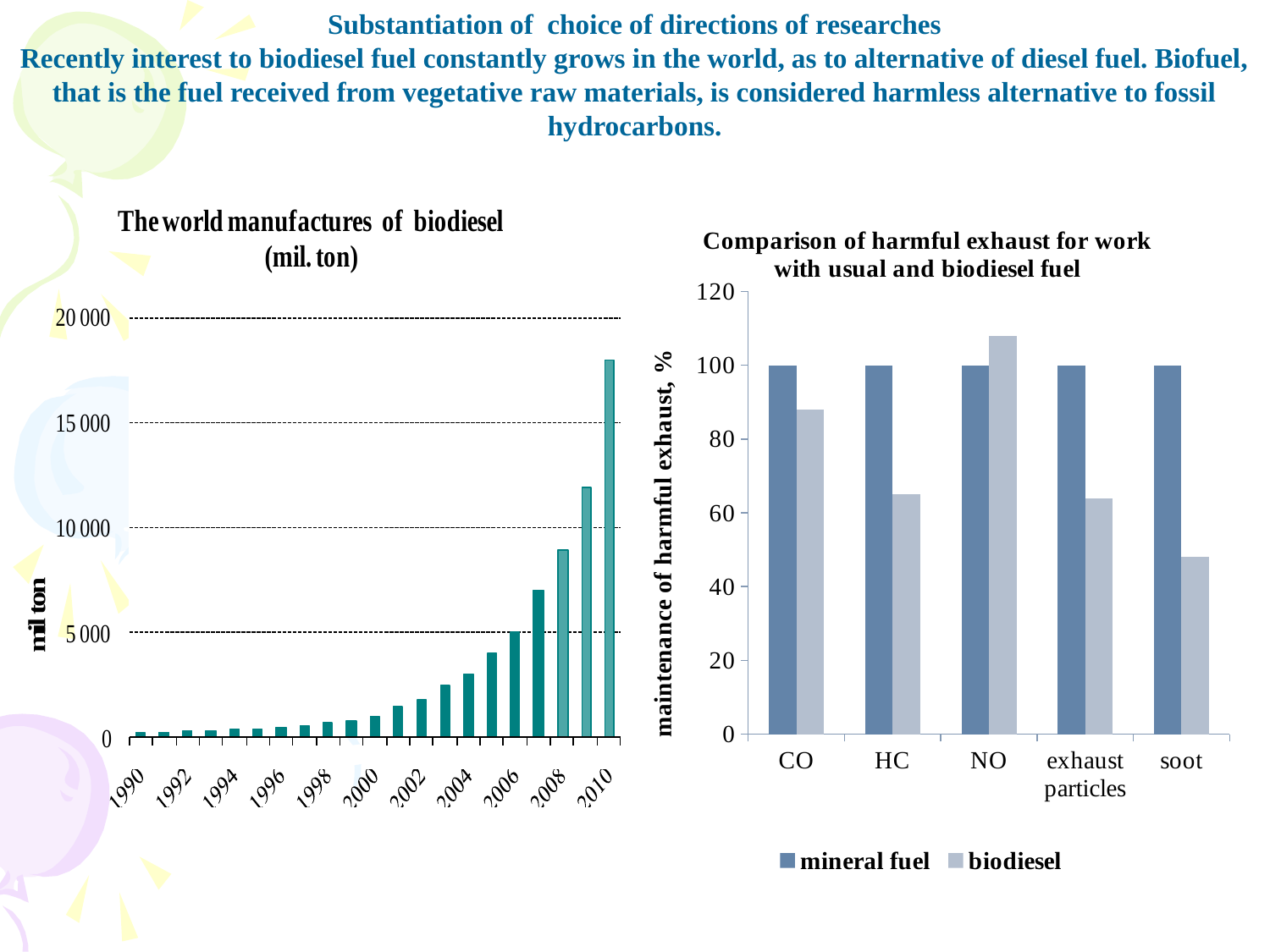
In 'Comparison of harmful exhaust for work with usual and biodiesel fuel', which category has the lowest biodiesel value? soot What kind of chart is 'The world manufactures of biodiesel (mil. ton)'? bar chart In 'The world manufactures of biodiesel (mil. ton)', do the values rise or fall from 1990 to 2010? rise In 'Comparison of harmful exhaust for work with usual and biodiesel fuel', what is the value for mineral fuel for CO? 100 In 'The world manufactures of biodiesel (mil. ton)', which year has the highest value? 2010 In 'Comparison of harmful exhaust for work with usual and biodiesel fuel', is the biodiesel value for soot greater or less than 60? less In 'The world manufactures of biodiesel (mil. ton)', is the value for 2008 greater or less than 10 000? less In 'The world manufactures of biodiesel (mil. ton)', is the value for 2000 greater or less than 5 000? less In 'Comparison of harmful exhaust for work with usual and biodiesel fuel', which category has the highest biodiesel value? NO In 'Comparison of harmful exhaust for work with usual and biodiesel fuel', how many categories are shown on the x axis? 5 In 'Comparison of harmful exhaust for work with usual and biodiesel fuel', how many series does the legend list? 2